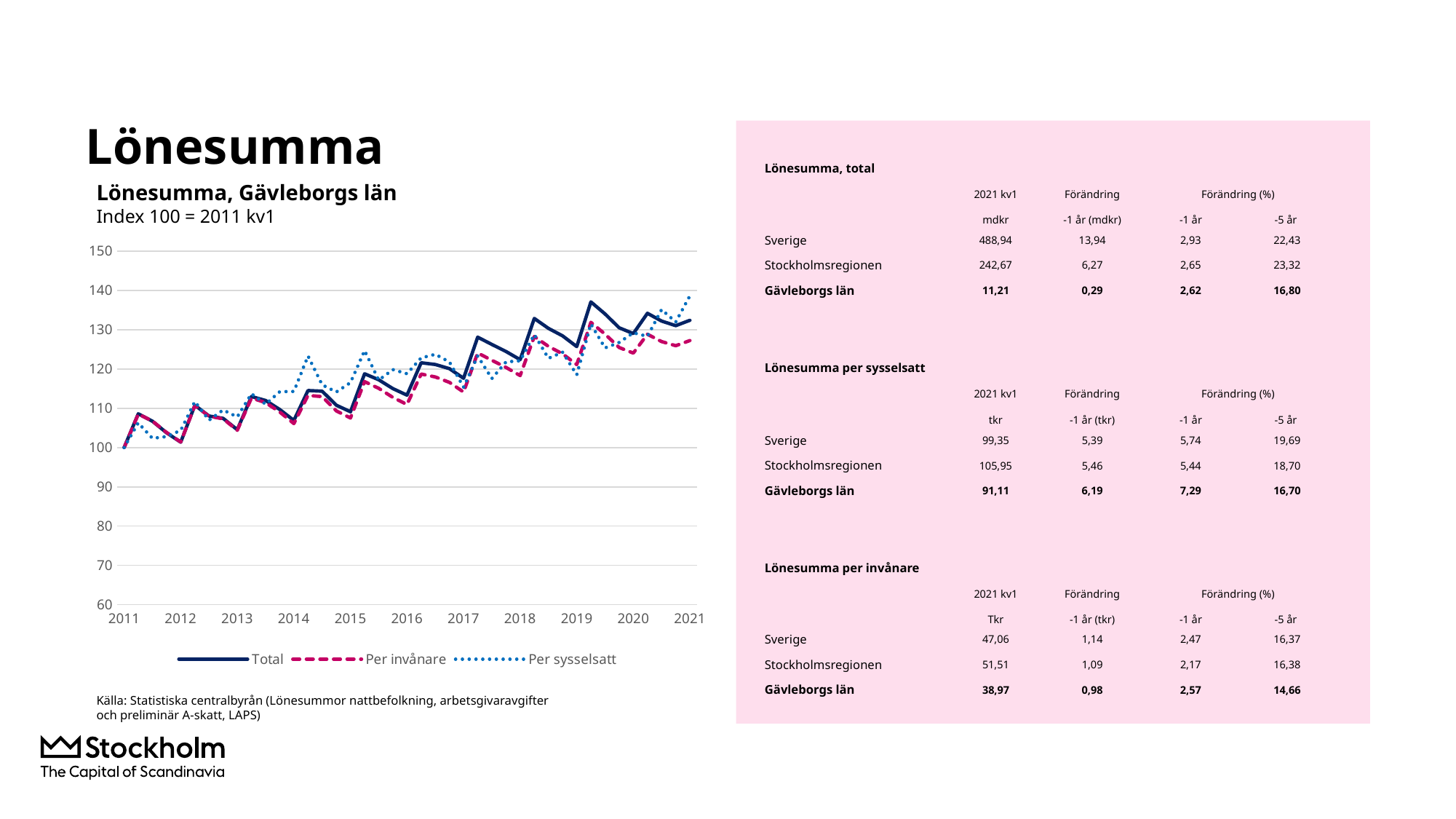
Is the value of the Per sysselsatt series at the end of 2021 greater or less than 130? greater How many series does the chart's legend list? 3 At the end of 2021, which series is higher: Per sysselsatt or Per invånare? Per sysselsatt Which series in the chart is drawn with a dotted line? Per sysselsatt Do the values in the chart generally rise or fall from 2011 to 2021? Rise How many years are labelled on the x axis of the chart? 11 Which series has the lowest value at the end of 2021? Per invånare Is the value of the Total series at its 2019 peak greater or less than 130? greater What is the title of the chart? Lönesumma, Gävleborgs län Is the value of the Total series at the start of 2017 greater or less than 120? less What is the index value of the series at 2011 kv1, the base period of the chart? 100 What kind of chart is shown on the slide? Line chart